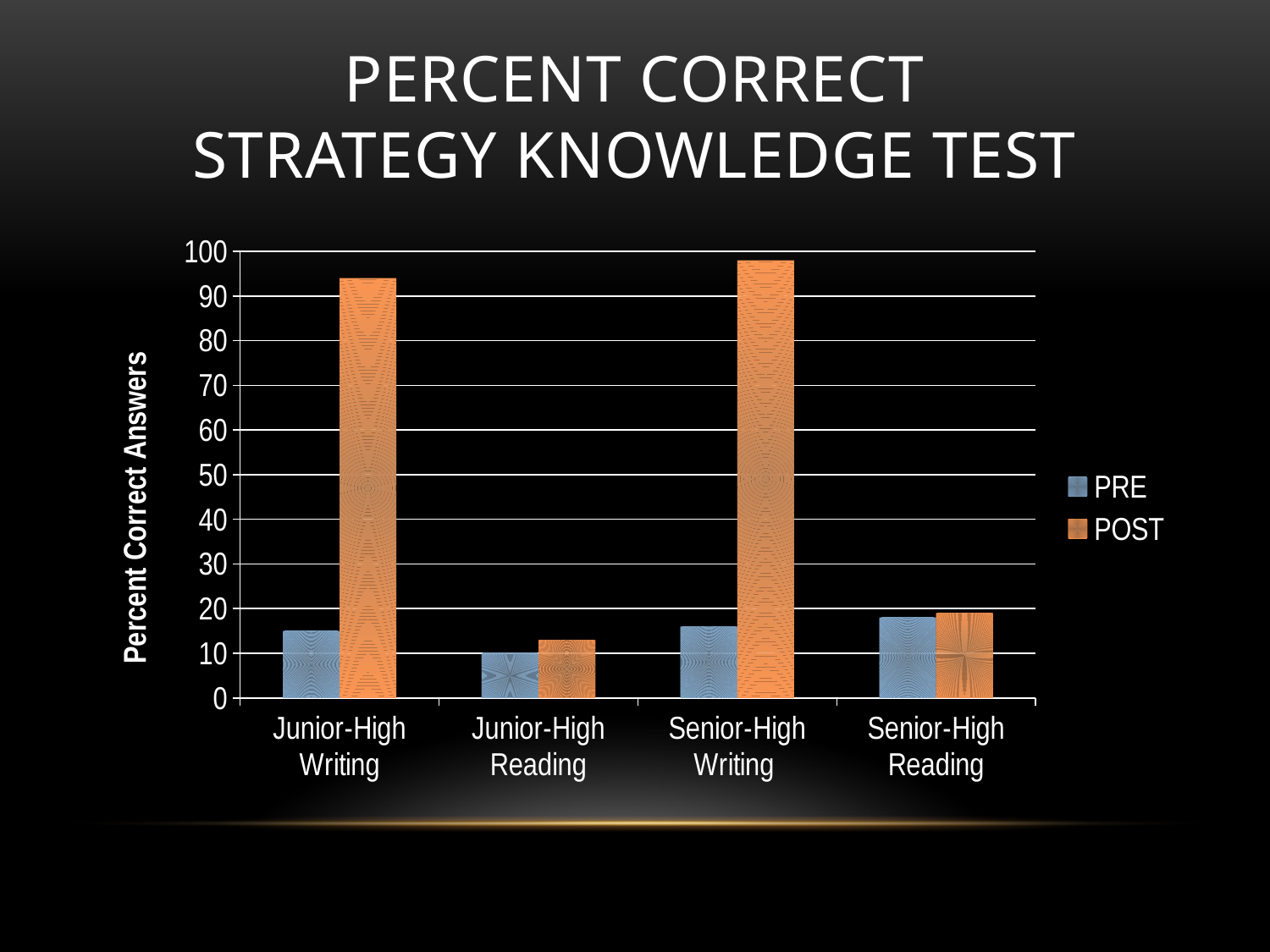
How many series does the legend list? 2 What is the label on the vertical axis? Percent Correct Answers Which category has the highest POST value? Senior-High Writing Is the POST value for Junior-High Writing greater or less than 90? greater Is the POST value for Senior-High Writing greater or less than 90? greater How many categories are shown on the x axis? 4 What kind of chart is shown on the slide? bar chart Which category has the lowest PRE value? Junior-High Reading Which is larger, the POST value for Junior-High Writing or the POST value for Junior-High Reading? Junior-High Writing Is the PRE value for Senior-High Reading greater or less than 20? less Which is larger for Senior-High Writing, the PRE value or the POST value? POST Which category has the lowest POST value? Junior-High Reading